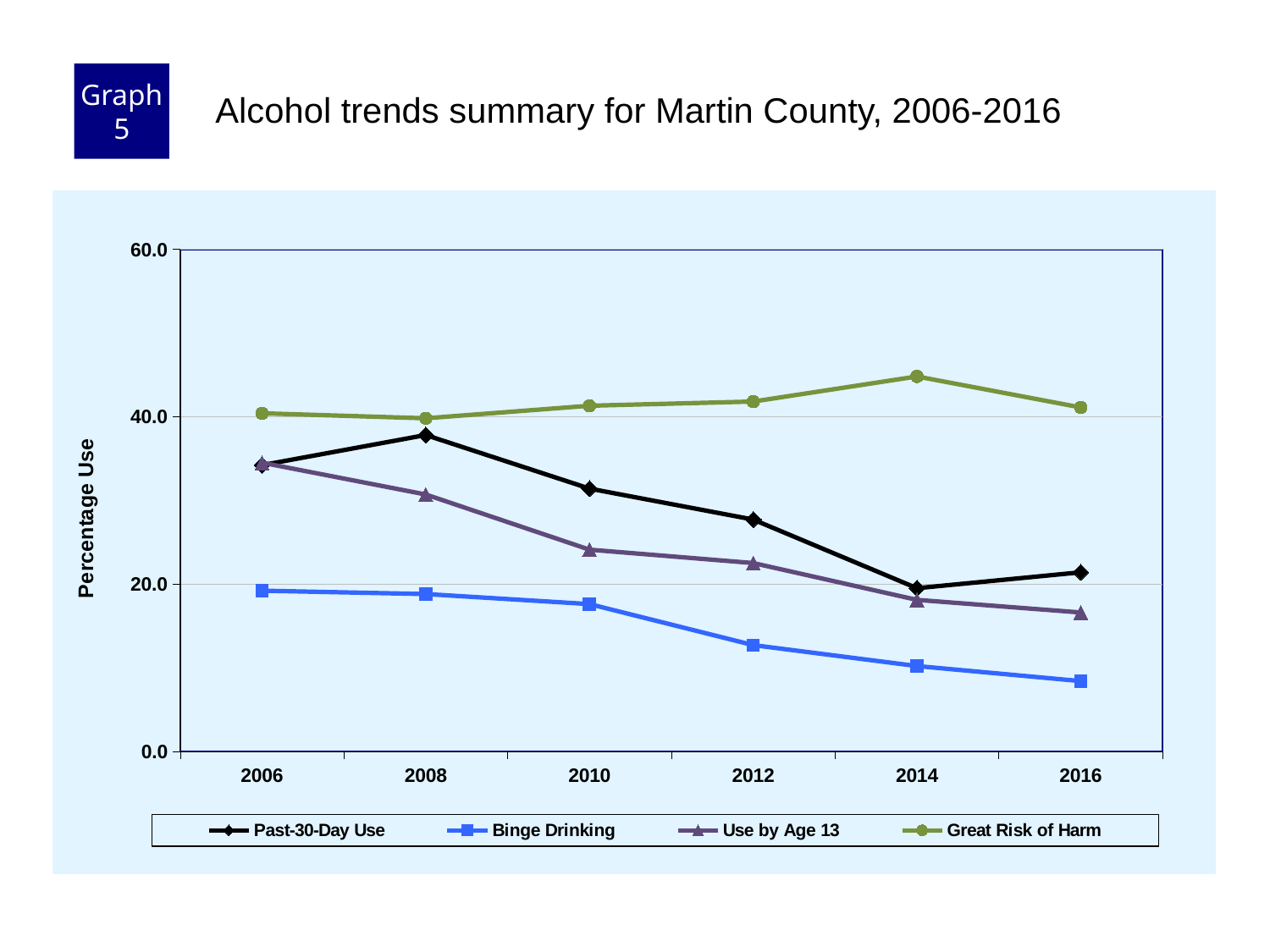
Does Binge Drinking rise or fall from 2006 to 2016? Fall Which series has the highest value in 2016? Great Risk of Harm Which series has the lowest value in 2016? Binge Drinking Is the value for Great Risk of Harm in 2014 greater or less than 40.0? greater How many series does the legend list? 4 In which year does Great Risk of Harm reach its highest value? 2014 How many years are plotted along the x axis? 6 In which year does Past-30-Day Use reach its highest value? 2008 What kind of chart is shown on the slide? Line chart What is the label on the y axis? Percentage Use In 2012, which is larger: Past-30-Day Use or Use by Age 13? Past-30-Day Use Is the value for Binge Drinking in 2016 greater or less than 20.0? less